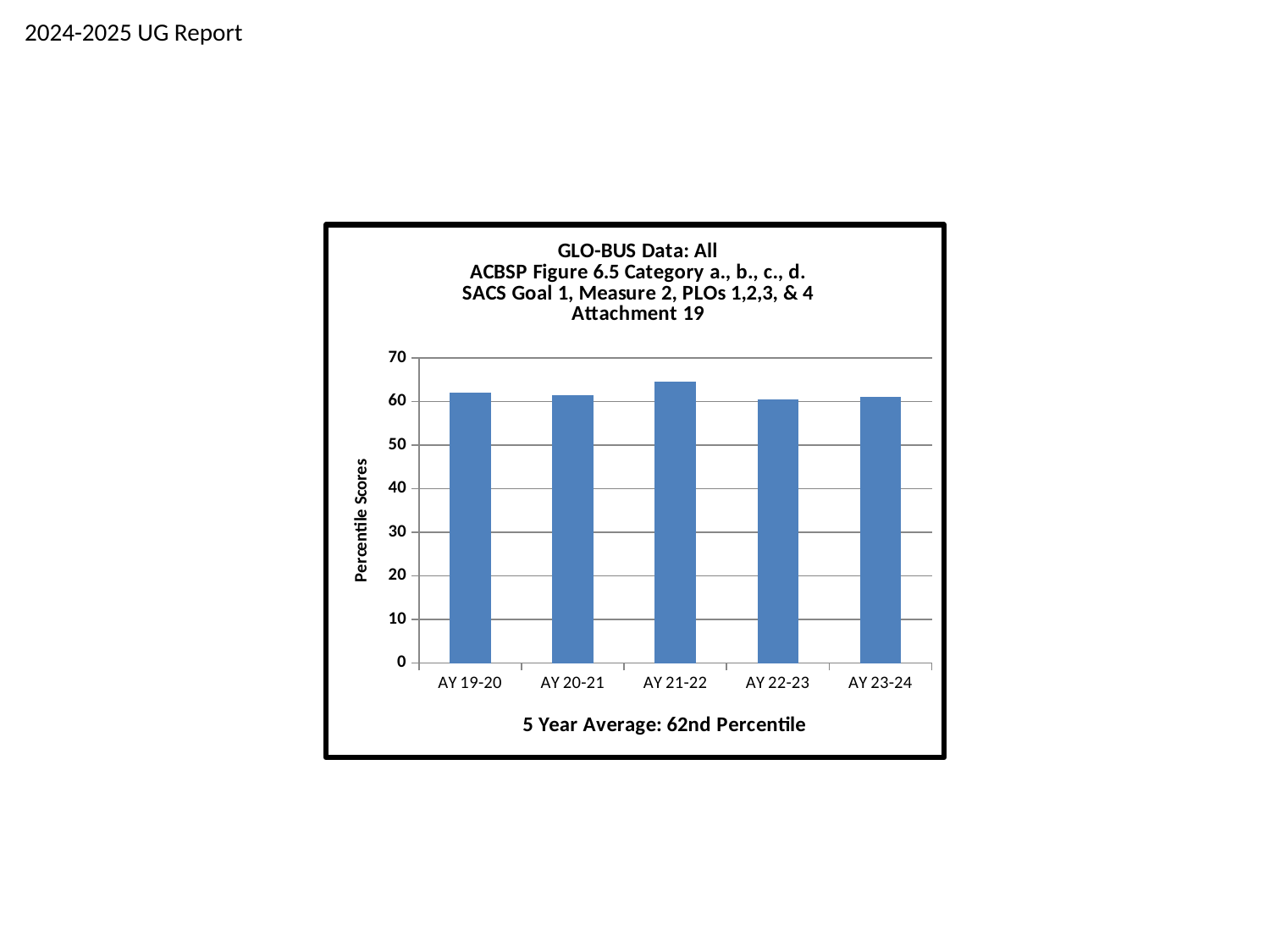
What kind of chart is shown on the slide? bar chart Is the value for AY 21-22 greater or less than 60? greater Is the value for AY 22-23 greater or less than 70? less Which academic year has the highest percentile score? AY 21-22 Which is larger, the value for AY 21-22 or the value for AY 20-21? AY 21-22 How many academic years are plotted on the chart? 5 What is the label on the vertical axis of the chart? Percentile Scores Is the value for AY 19-20 greater or less than 50? greater Which is larger, the value for AY 21-22 or the value for AY 22-23? AY 21-22 What 5 year average is stated below the horizontal axis of the chart? 62nd Percentile